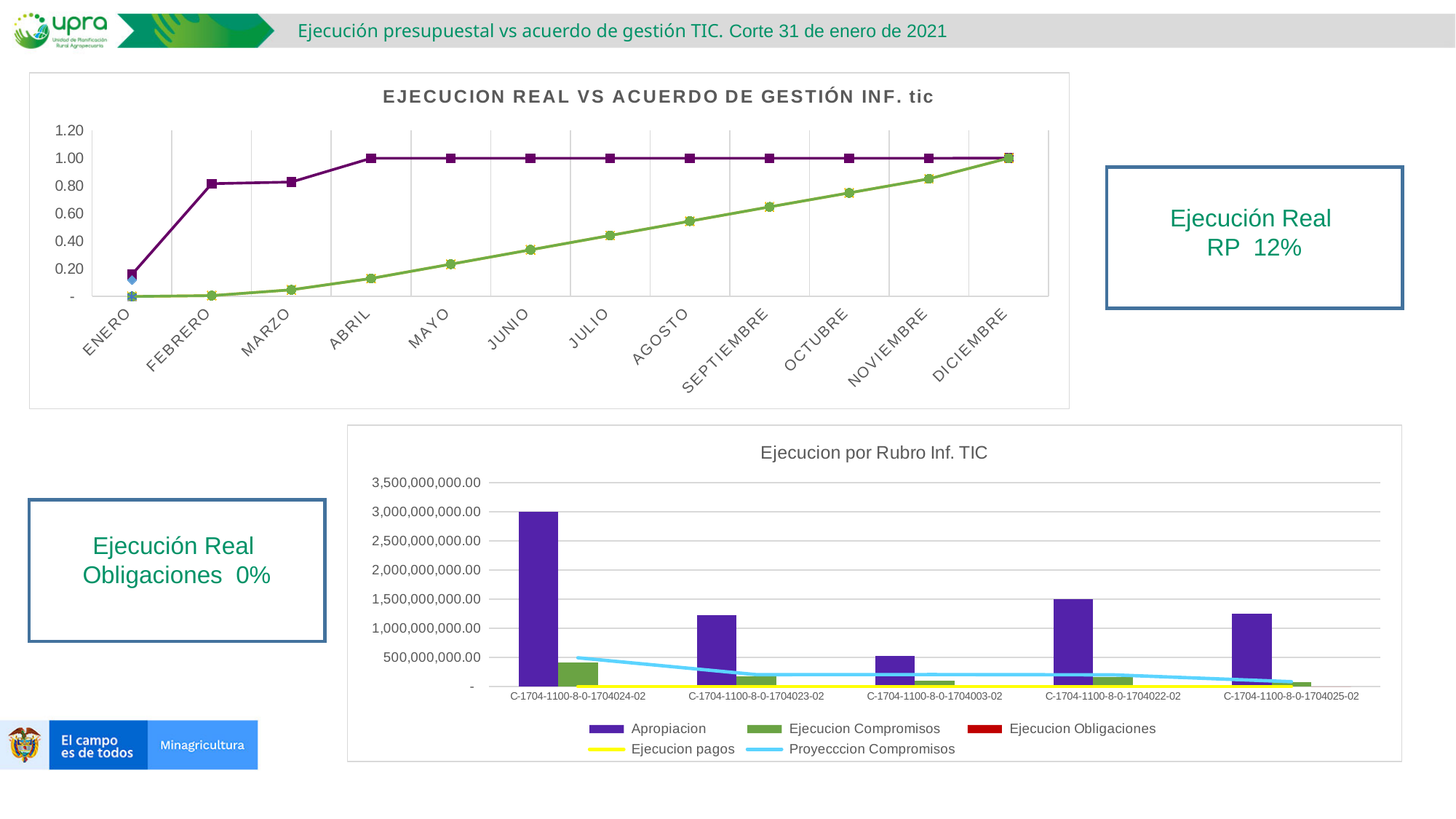
In the top chart 'EJECUCION REAL VS ACUERDO DE GESTIÓN INF. tic', does the green line rise or fall from ENERO to DICIEMBRE? rise In the top chart 'EJECUCION REAL VS ACUERDO DE GESTIÓN INF. tic', is the value of the purple line for ENERO greater or less than 0.40? less In the bottom chart 'Ejecucion por Rubro Inf. TIC', how many rubro categories are shown on the x axis? 5 In the top chart 'EJECUCION REAL VS ACUERDO DE GESTIÓN INF. tic', is the value of the green line for AGOSTO greater or less than 0.40? greater In the top chart 'EJECUCION REAL VS ACUERDO DE GESTIÓN INF. tic', is the value of the green line for OCTUBRE greater or less than 0.80? less In the top chart 'EJECUCION REAL VS ACUERDO DE GESTIÓN INF. tic', how many months are shown on the x axis? 12 What type of chart is the top chart titled 'EJECUCION REAL VS ACUERDO DE GESTIÓN INF. tic'? line chart In the bottom chart 'Ejecucion por Rubro Inf. TIC', which category has the lowest Apropiacion? C-1704-1100-8-0-1704003-02 In the bottom chart 'Ejecucion por Rubro Inf. TIC', which category has the highest Apropiacion? C-1704-1100-8-0-1704024-02 In the bottom chart 'Ejecucion por Rubro Inf. TIC', which series is shown in yellow in the legend? Ejecucion pagos In the bottom chart 'Ejecucion por Rubro Inf. TIC', how many series does the legend list? 5